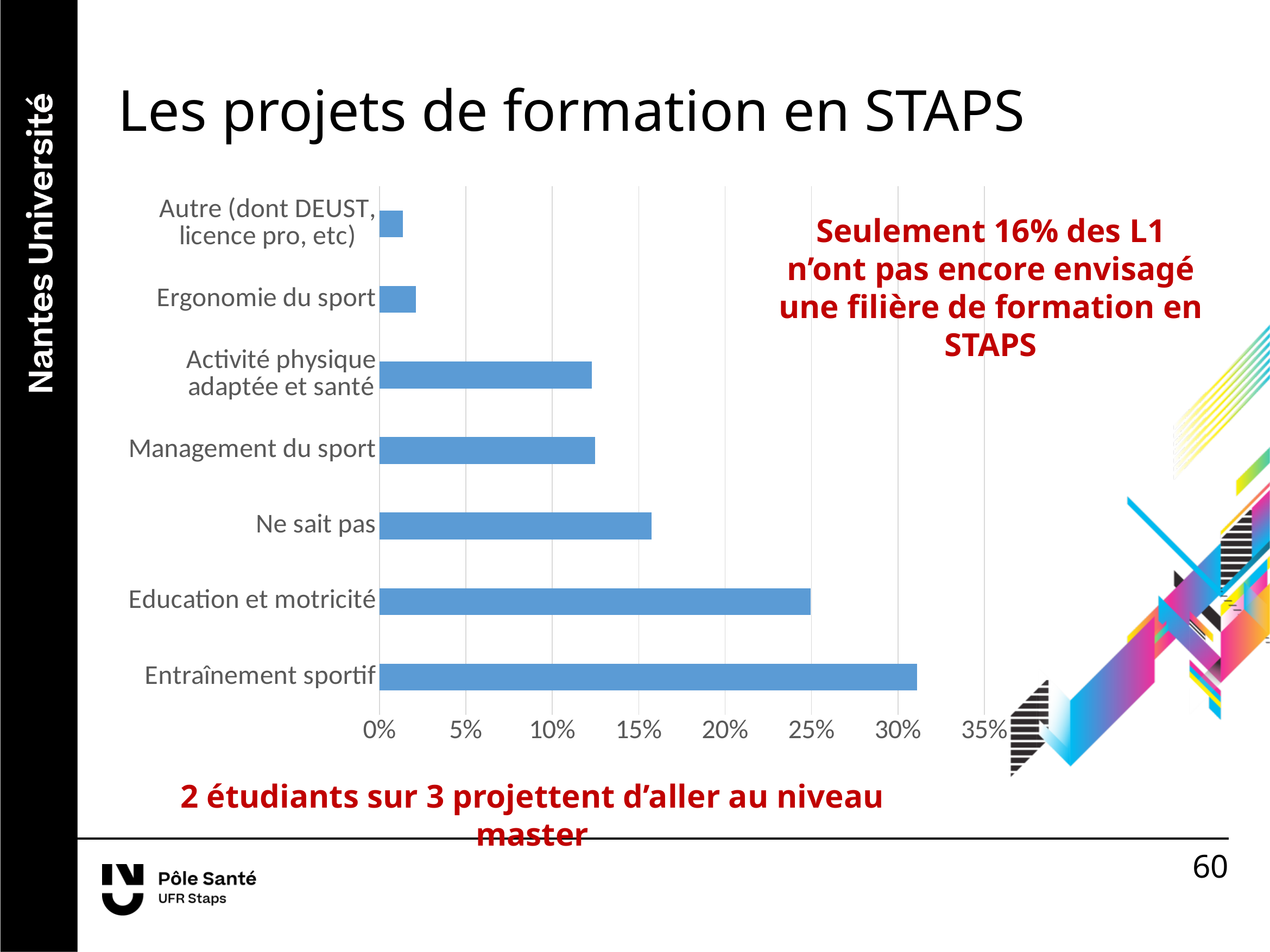
Is the value for Ergonomie du sport greater or less than 5%? less Is the value for Ne sait pas greater or less than 20%? less Is the value for Management du sport greater or less than 10%? greater Which is larger, the value for Education et motricité or the value for Ne sait pas? Education et motricité What kind of chart is shown on the slide? bar chart Which category has the highest value in the chart? Entraînement sportif What is the highest value shown on the horizontal axis of the chart? 35% How many categories are plotted in the bar chart? 7 Which is larger, the value for Activité physique adaptée et santé or the value for Ergonomie du sport? Activité physique adaptée et santé Which category has the lowest value in the chart? Autre (dont DEUST, licence pro, etc)